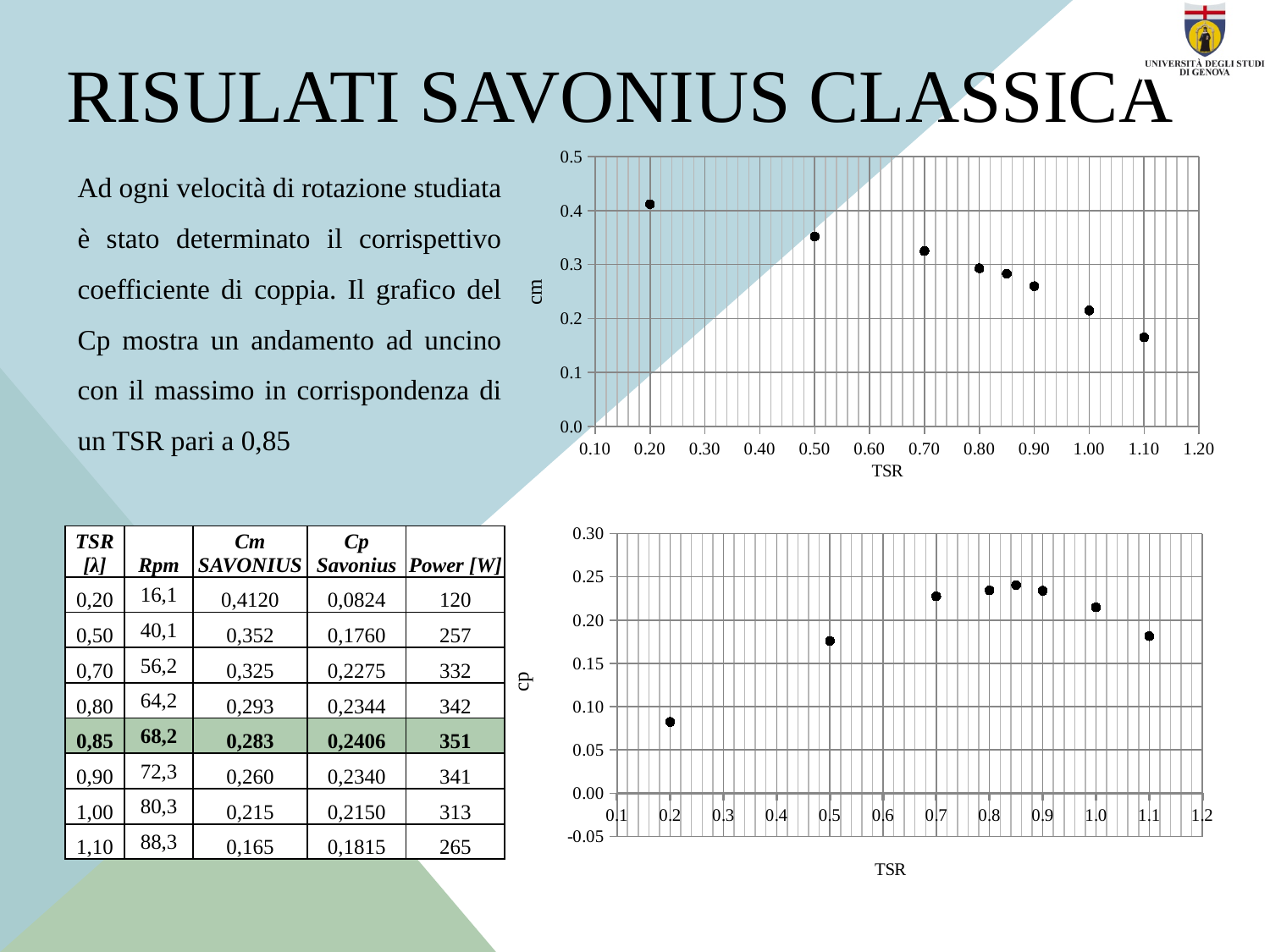
In the bottom chart (cp vs TSR), is the cp value at TSR 0.2 greater or less than 0.10? less How many data points are plotted in the top chart (cm vs TSR)? 8 What is the label on the vertical axis of the top chart? cm In the top chart (cm vs TSR), do the values rise or fall as TSR increases? fall What kind of chart is the top chart (cm vs TSR)? scatter chart In the top chart (cm vs TSR), is the cm value at TSR 0.20 greater or less than 0.4? greater In the top chart (cm vs TSR), is the cm value at TSR 1.10 greater or less than 0.2? less In the top chart (cm vs TSR), at which TSR is the cm value lowest? 1.10 In the bottom chart (cp vs TSR), at which TSR is the cp value lowest? 0.2 In the top chart (cm vs TSR), at which TSR is the cm value highest? 0.20 In the top chart (cm vs TSR), which has the larger cm value: TSR 0.50 or TSR 0.70? TSR 0.50 How many data points are plotted in the bottom chart (cp vs TSR)? 8